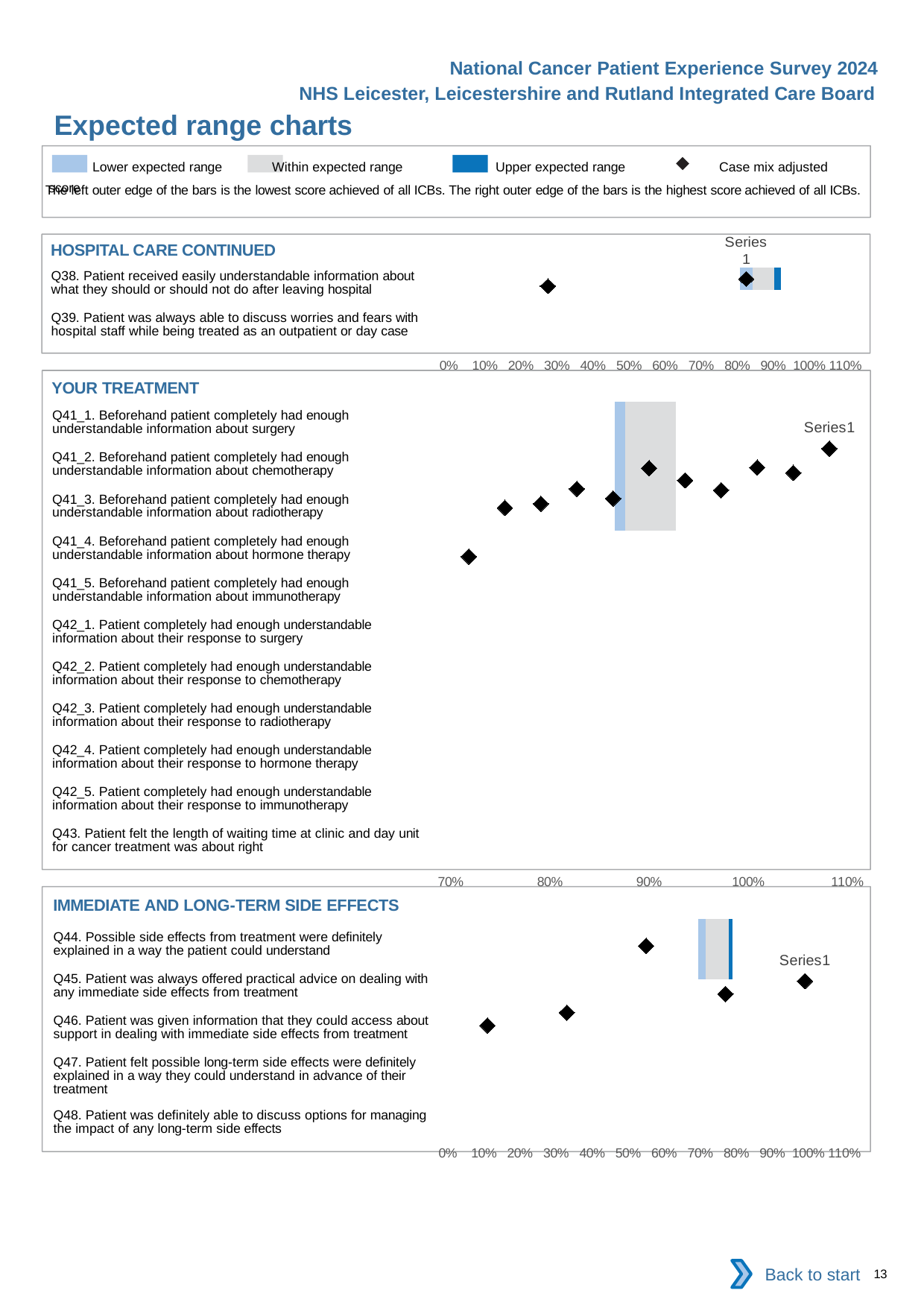
In the 'YOUR TREATMENT' chart, how many questions (categories) are listed? 11 In the 'YOUR TREATMENT' chart, how many diamond markers are plotted? 11 In the 'HOSPITAL CARE CONTINUED' chart, how many questions (categories) are listed? 2 In the 'YOUR TREATMENT' chart, what is the lowest value shown on the horizontal axis? 70% In the 'IMMEDIATE AND LONG-TERM SIDE EFFECTS' chart, what is the highest value shown on the horizontal axis? 110% In the 'IMMEDIATE AND LONG-TERM SIDE EFFECTS' chart, what is the name of the plotted series? Series1